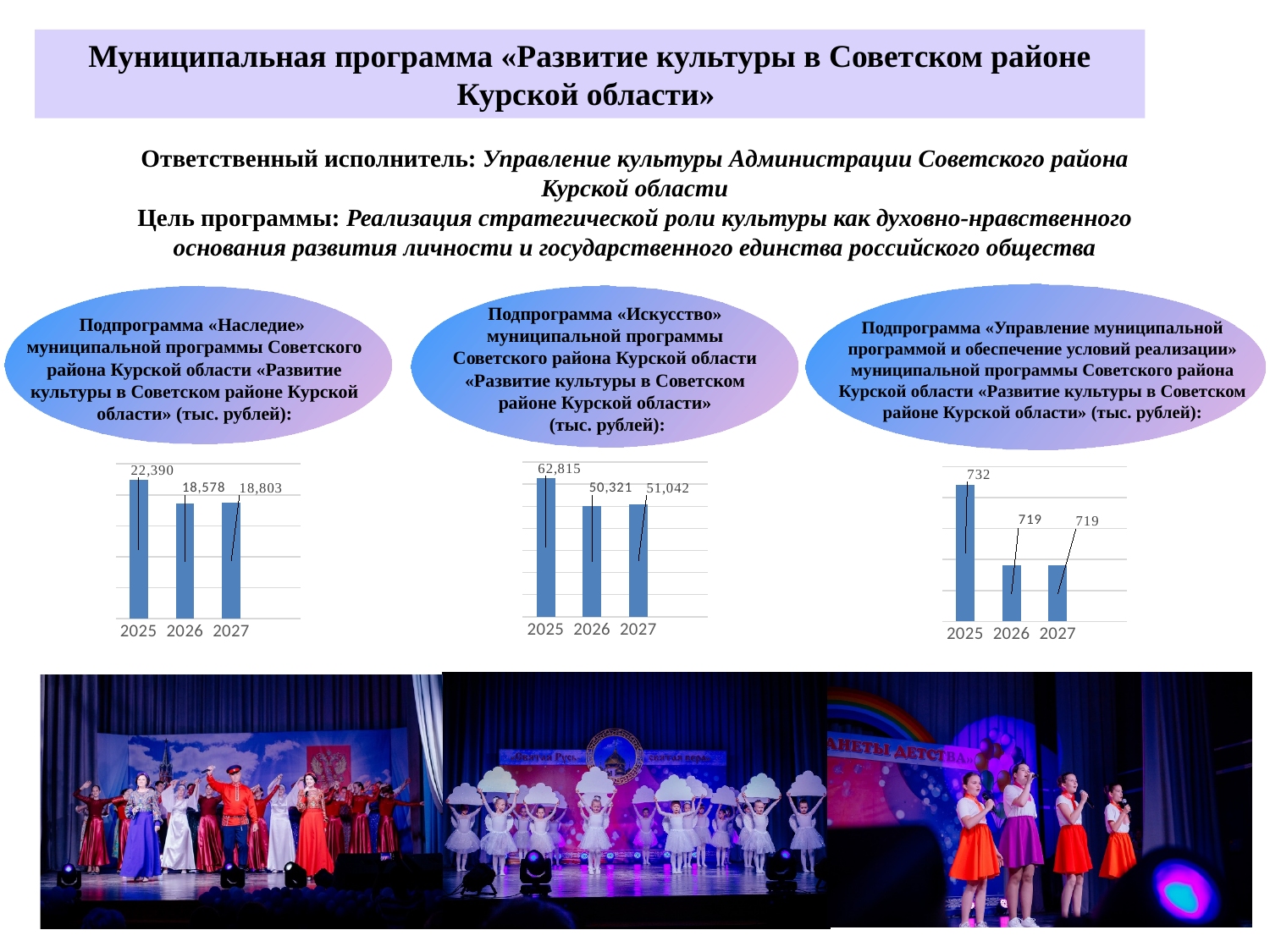
In the middle chart (Подпрограмма «Искусство»), what is the value for 2025? 62,815 In the left chart (Подпрограмма «Наследие»), what is the value for 2025? 22,390 In the left chart (Подпрограмма «Наследие»), which year has the lowest value? 2026 In the right chart (Подпрограмма «Управление муниципальной программой...»), what is the value for 2027? 719 In the middle chart (Подпрограмма «Искусство»), which year has the highest value? 2025 In the left chart (Подпрограмма «Наследие»), what is the value for 2027? 18,803 How many years (categories) are shown in the left chart (Подпрограмма «Наследие»)? 3 What kind of chart is the middle chart (Подпрограмма «Искусство»)? Bar chart In the middle chart (Подпрограмма «Искусство»), what is the difference between the 2027 and 2026 values? 721 In the left chart (Подпрограмма «Наследие»), what is the difference between the 2025 and 2026 values? 3,812 In the middle chart (Подпрограмма «Искусство»), what is the value for 2026? 50,321 In the right chart (Подпрограмма «Управление муниципальной программой...»), what is the value for 2025? 732